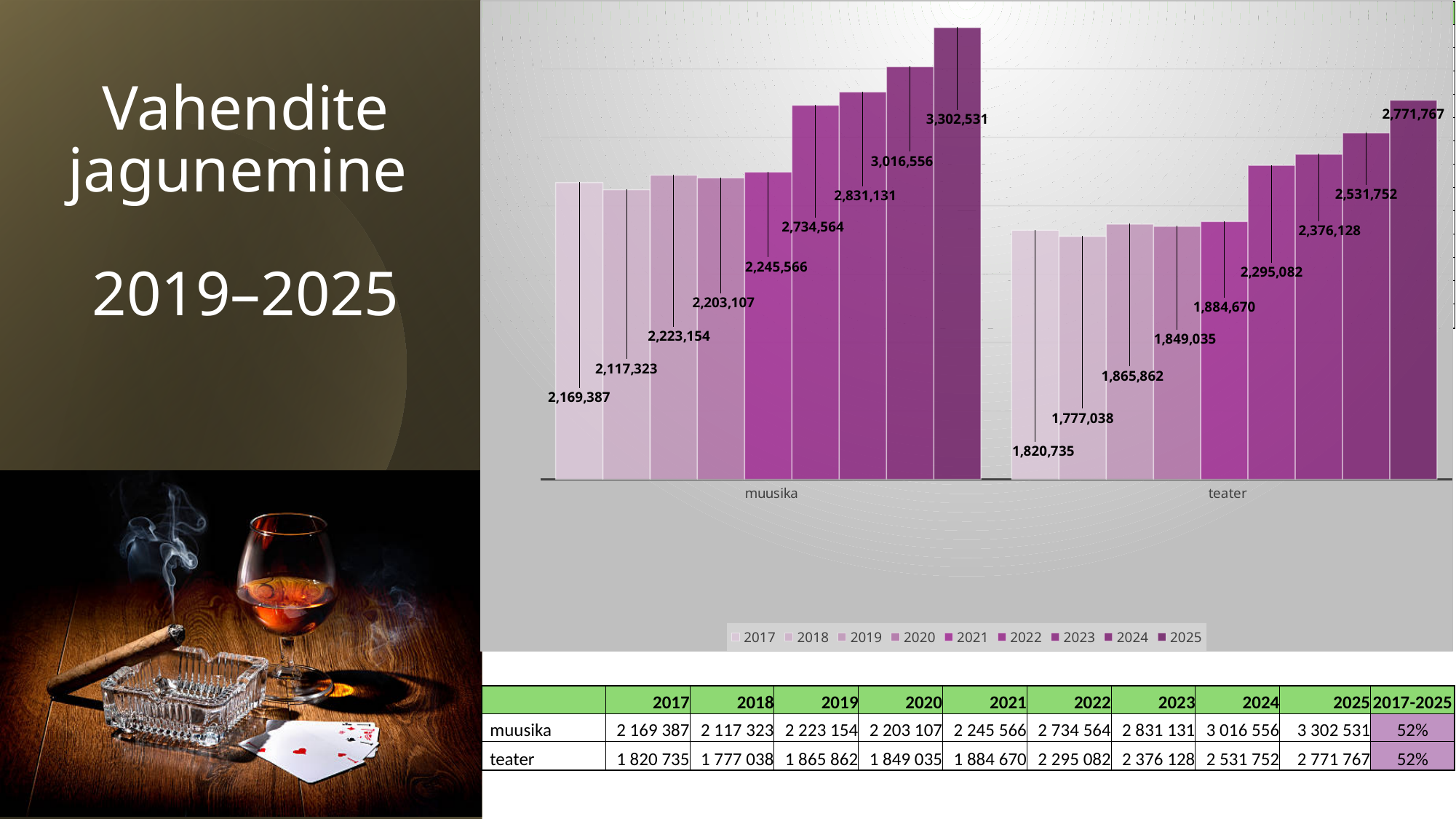
What is the value for teater in 2017? 1,820,735 Which year has the lowest value for muusika? 2018 What is the value for muusika in 2025? 3,302,531 Which category is labelled on the left side of the chart? muusika Which is larger, the muusika value in 2021 or the teater value in 2022? teater in 2022 What is the value for muusika in 2022? 2,734,564 How many categories are shown on the x axis of the chart? 2 How many series does the chart legend list? 9 What kind of chart is shown on the slide? bar chart What is the value for teater in 2023? 2,376,128 Which year has the highest value for teater? 2025 What is the difference between the muusika and teater values in 2025? 530,764